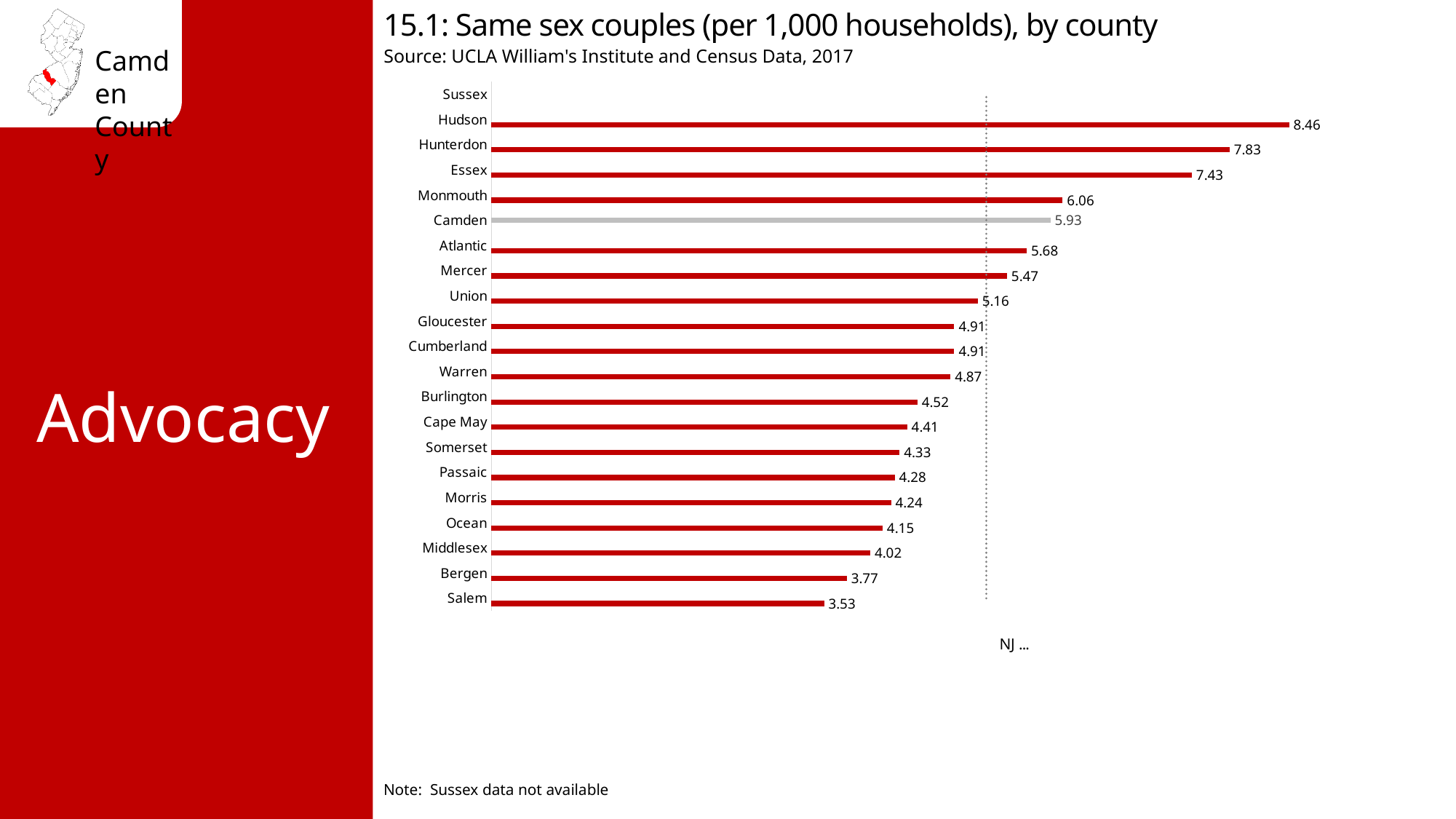
What is the value for Camden? 5.93 What is the difference between the values for Hudson and Camden? 2.53 Which has a larger value, Bergen or Middlesex? Middlesex What is the difference between the values for Monmouth and Atlantic? 0.38 Which county has the lowest value among those with data shown? Salem How many counties are listed on the y axis of the chart? 21 What is the value for Burlington? 4.52 What type of chart is shown on the slide? Bar chart Which county has the highest value? Hudson What is the value for Hudson? 8.46 What is the value for Salem? 3.53 Which has a larger value, Essex or Mercer? Essex